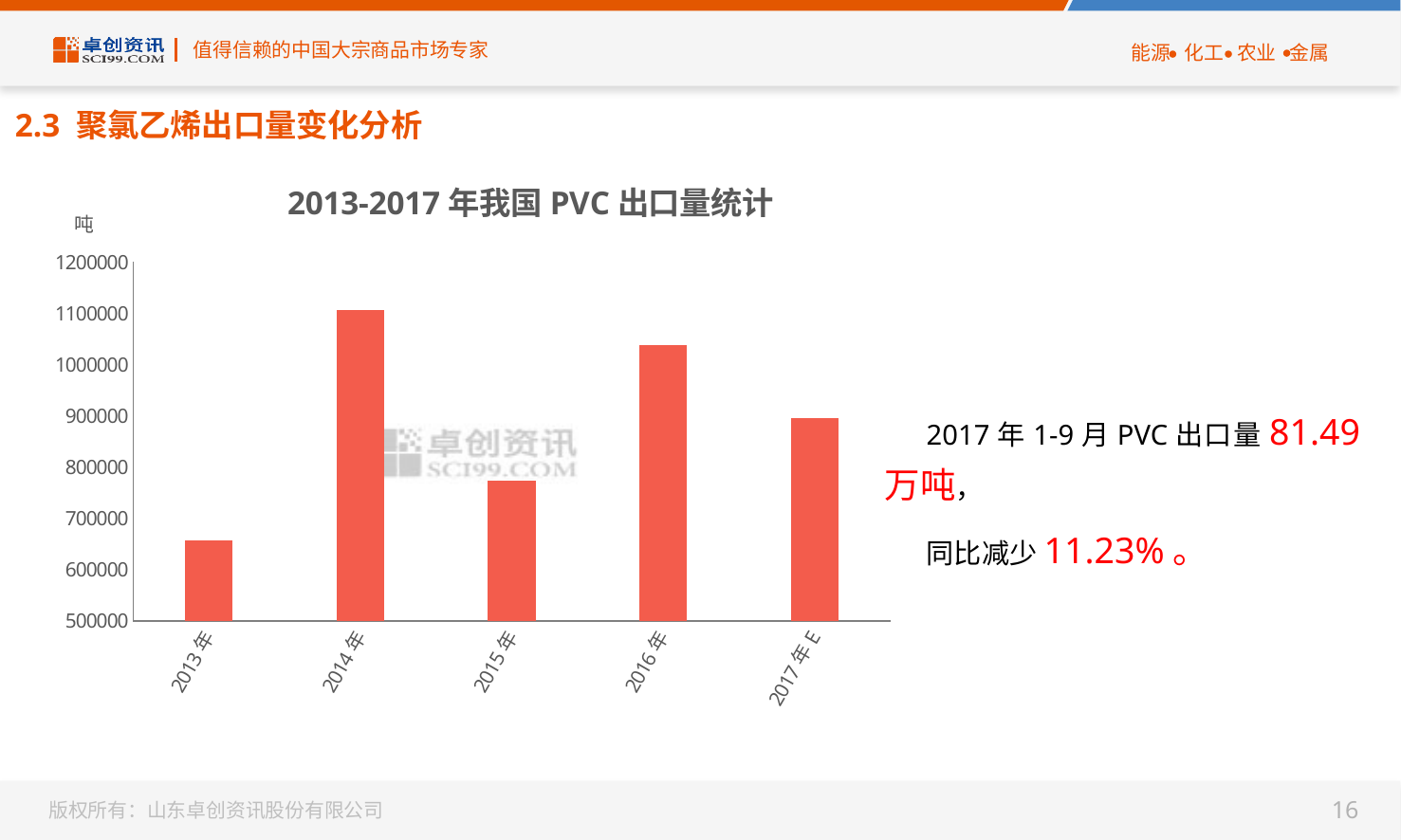
Which year has the lowest PVC export volume in the chart? 2013年 What kind of chart is shown on the slide? bar chart What is the title of the chart? 2013-2017 年我国 PVC 出口量统计 Is the value for 2016年 greater or less than 1000000? greater Is the value for 2013年 greater or less than 700000? less Which is larger, the value for 2014年 or the value for 2016年? 2014年 Is the value for 2017年E greater or less than 800000? greater Which year has the highest PVC export volume in the chart? 2014年 Which is larger, the value for 2015年 or the value for 2017年E? 2017年E How many years (categories) are plotted in the chart? 5